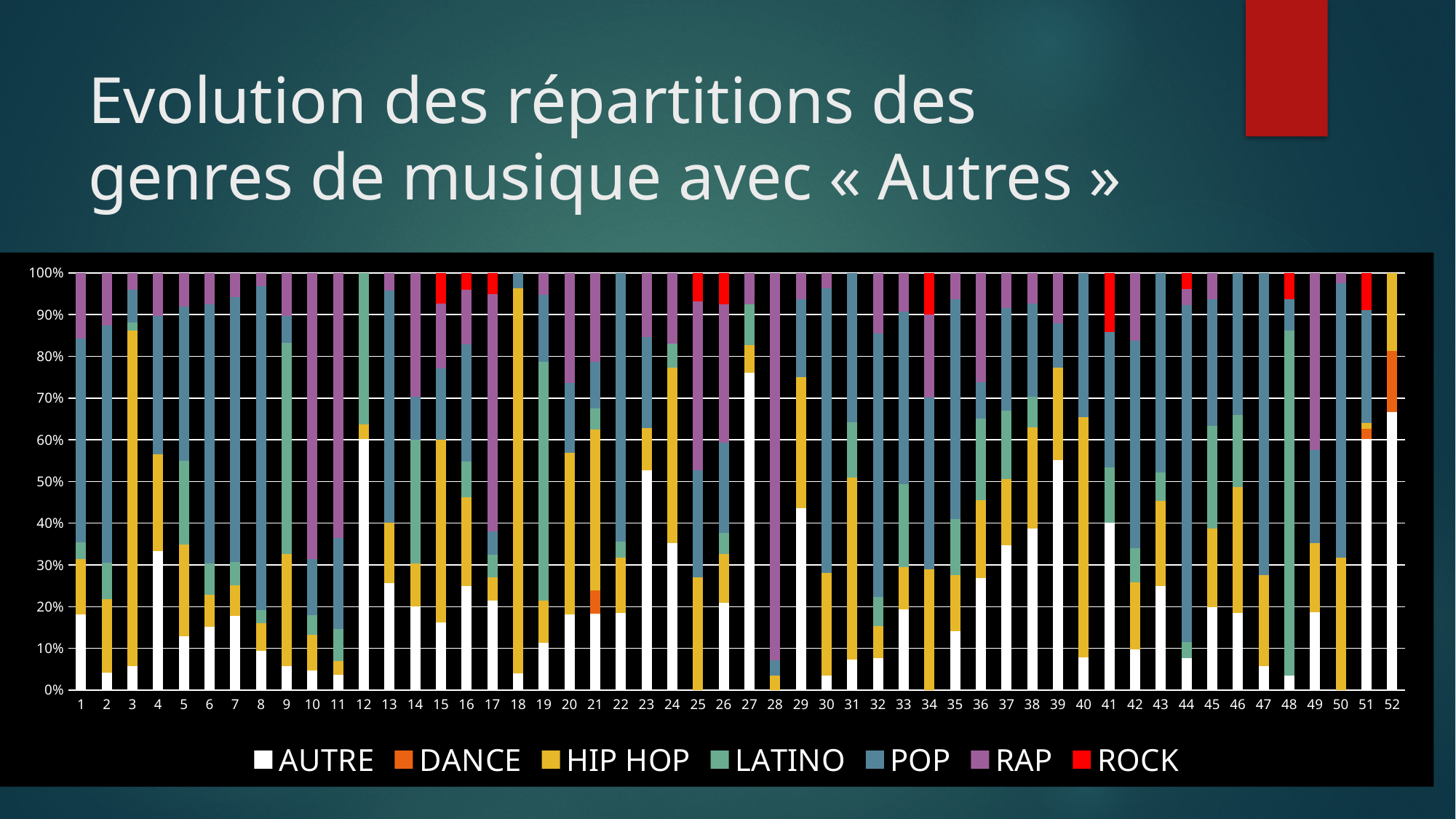
Which category has the largest AUTRE share in the chart? 27 Is the AUTRE share for category 28 greater or less than 10%? less What is the title of the slide containing the chart? Evolution des répartitions des genres de musique avec « Autres » How many categories are plotted along the x axis of the chart? 52 Is the AUTRE share for category 12 greater or less than 50%? greater How many series does the chart's legend list? 7 Is the AUTRE share for category 52 greater or less than 60%? greater What is the total height of each stacked bar in the chart? 100% Which series is shown in red in the chart's legend? ROCK Which has the larger AUTRE share, category 27 or category 2? Category 27 What kind of chart is shown on the slide? Stacked bar chart